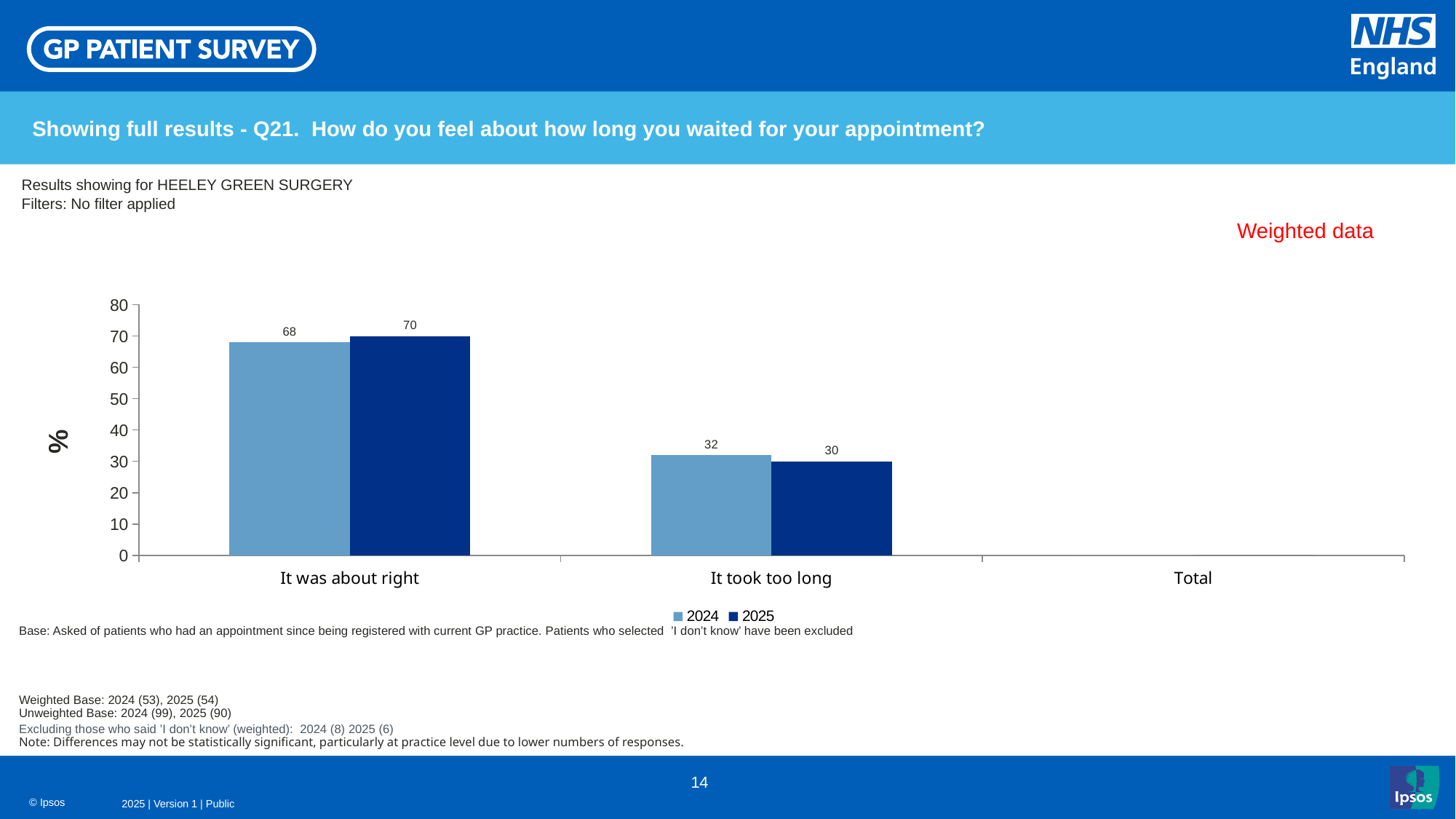
What is the 2025 value for 'It took too long'? 30 How many series does the legend list? 2 What is the 2025 value for 'It was about right'? 70 What is the difference between the 2025 and 2024 values for 'It was about right'? 2 What is the 2024 value for 'It took too long'? 32 Which category has the lowest value in the 2024 series? It took too long Which category has the highest value in the 2025 series? It was about right Which is larger for 'It took too long': the 2024 value or the 2025 value? 2024 What kind of chart is shown on the slide? Bar chart What is the 2024 value for 'It was about right'? 68 Is the 2025 value for 'It was about right' greater or less than 60? greater What label is shown on the y axis of the chart? %